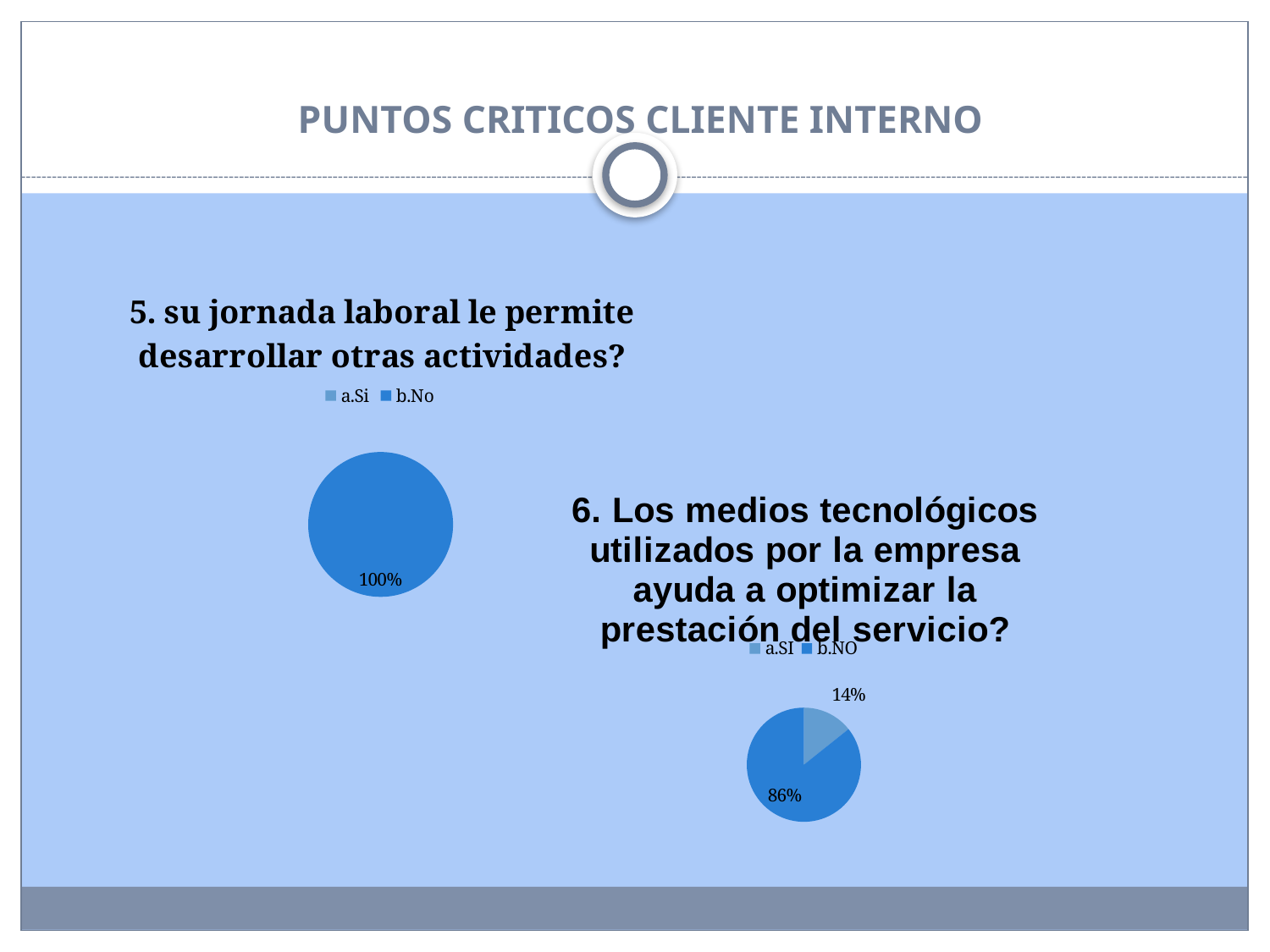
In the chart for question 6, which response has the largest share? b.NO In the chart for question 5, what percentage is shown on the single slice? 100% In the chart for question 5, which legend entry does the 100% slice correspond to? b.No What kind of chart is used for question 6 (Los medios tecnológicos utilizados por la empresa...)? pie chart In the chart for question 6, what is the share for a.SI? 14% In the chart for question 6, which response has the smallest share? a.SI What kind of chart is used for question 5 (su jornada laboral le permite desarrollar otras actividades?)? pie chart In the chart for question 6, what is the difference between the b.NO share and the a.SI share? 72% In the chart for question 6, which is larger, a.SI or b.NO? b.NO In the chart for question 6, what is the share for b.NO? 86% How many entries does the legend list for the chart for question 5? 2 How many slices are visible in the pie chart for question 6? 2